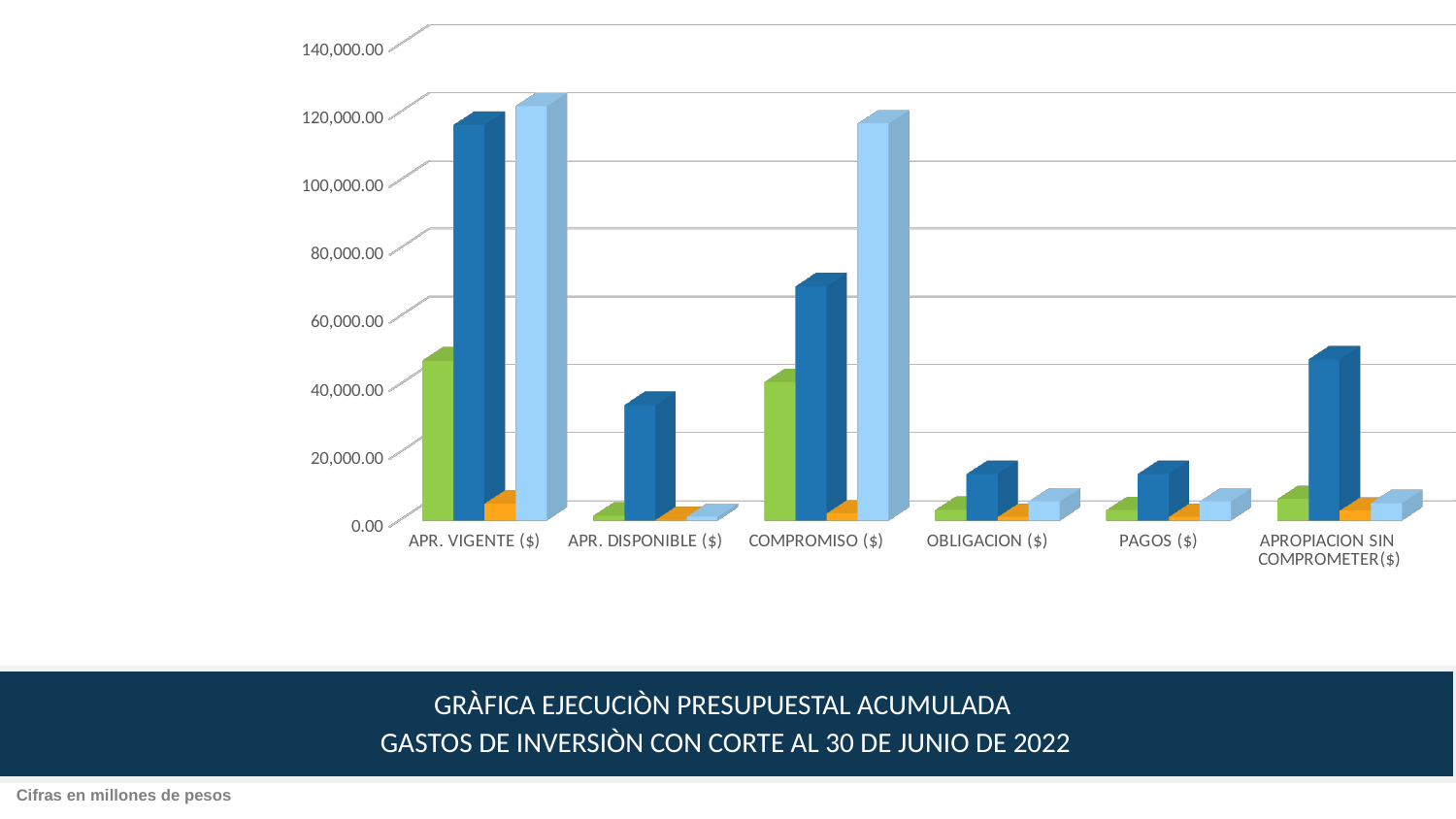
Is the light blue bar for COMPROMISO ($) greater or less than 100,000.00? greater Is the dark blue bar for PAGOS ($) greater or less than 20,000.00? less Is the green bar for COMPROMISO ($) greater or less than 60,000.00? less Which category has the tallest dark blue bar? APR. VIGENTE ($) Which has the taller dark blue bar, APR. VIGENTE ($) or COMPROMISO ($)? APR. VIGENTE ($) Which has the taller green bar, APR. VIGENTE ($) or OBLIGACION ($)? APR. VIGENTE ($) What kind of chart is shown on the slide? bar chart How many categories are shown along the x axis of the chart? 6 According to the note at the bottom of the slide, in what units are the figures expressed? Cifras en millones de pesos